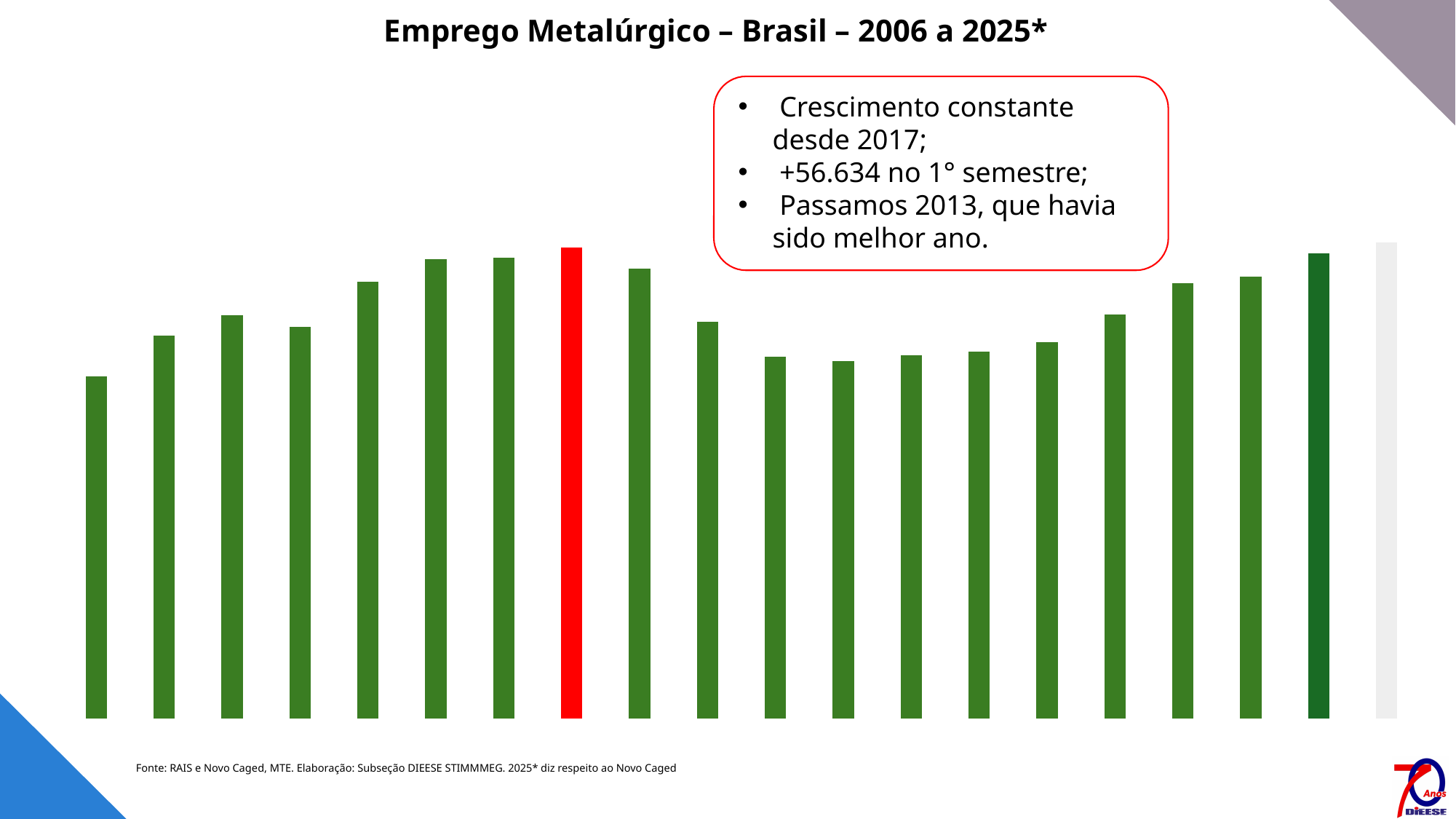
How many bars does the chart contain? 20 Which bar has the lowest value in the chart? The leftmost bar (2006) Do the bars rise or fall over the last eight bars of the chart? Rise Which is larger, the last (grey) bar or the bar immediately to its left? The last (grey) bar Do the bars rise or fall from the red bar to the fourth bar after it? Fall What kind of chart is shown on the slide? Bar chart Which is larger, the leftmost bar or the second bar from the left? The second bar Which bar is highlighted in red? The eighth bar (2013) What is the title of the chart? Emprego Metalúrgico – Brasil – 2006 a 2025* Which is larger, the red bar or the leftmost bar? The red bar